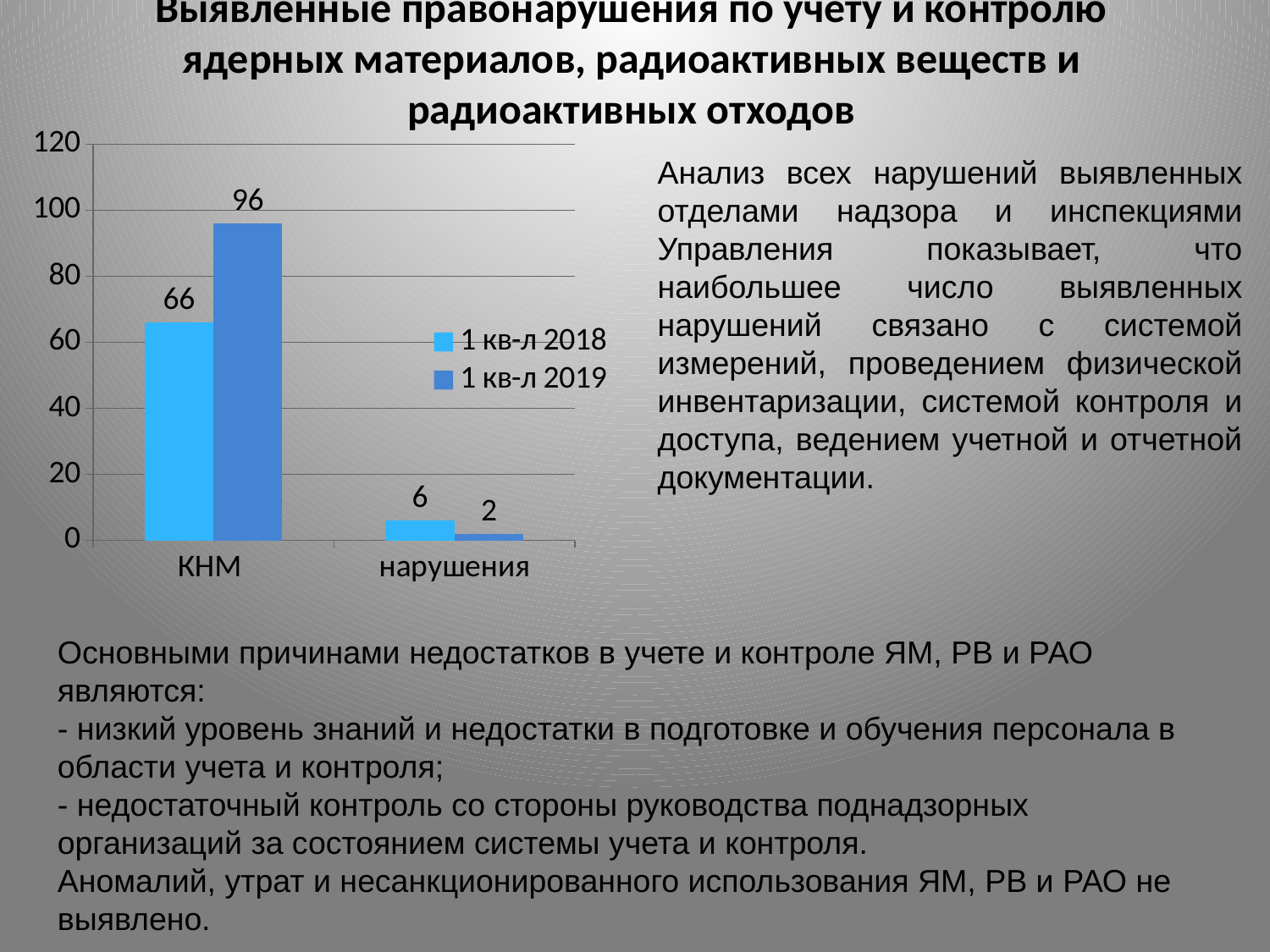
What is the value for нарушения in the 1 кв-л 2018 series? 6 What is the difference between the 1 кв-л 2019 and 1 кв-л 2018 values for КНМ? 30 Which category has the highest value in the 1 кв-л 2019 series? КНМ What is the difference between the 1 кв-л 2018 and 1 кв-л 2019 values for нарушения? 4 For нарушения, which series has the larger value, 1 кв-л 2018 or 1 кв-л 2019? 1 кв-л 2018 How many series does the chart legend list? 2 What is the value for нарушения in the 1 кв-л 2019 series? 2 How many categories are shown on the x axis of the chart? 2 What is the value for КНМ in the 1 кв-л 2018 series? 66 Which category has the lowest value in the 1 кв-л 2018 series? нарушения What kind of chart is shown on the slide? bar chart What is the value for КНМ in the 1 кв-л 2019 series? 96